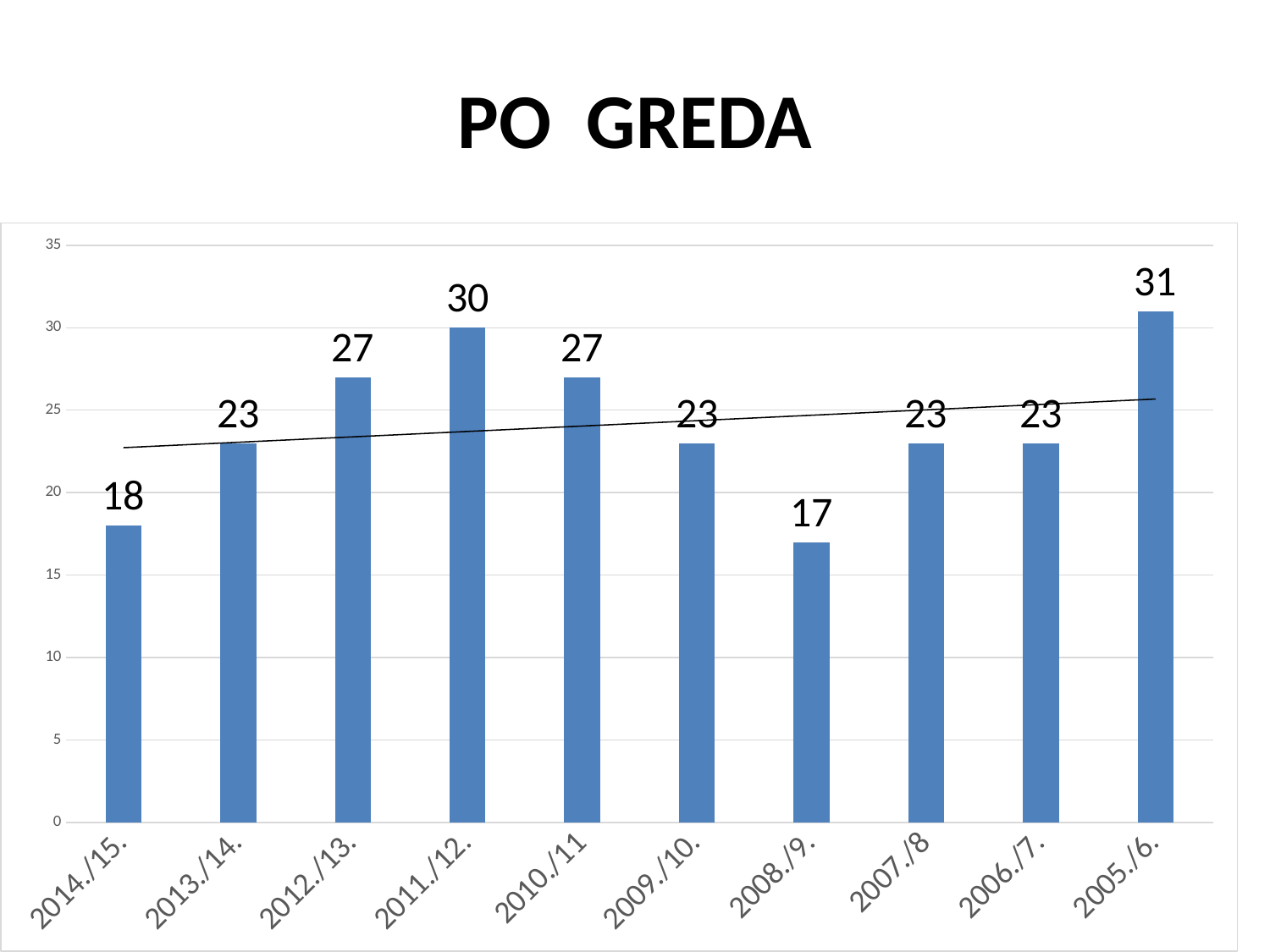
What is the title of the slide? PO GREDA What is the difference between the values for 2005./6. and 2014./15.? 13 What is the value for 2008./9.? 17 What is the value for 2014./15.? 18 Which is larger, the value for 2012./13. or the value for 2009./10.? 2012./13. Which category has the lowest value? 2008./9. What kind of chart is shown on the slide? bar chart How many categories are shown on the x axis? 10 What is the value for 2011./12.? 30 Is the value for 2010./11 greater or less than 25? greater Which category has the highest value? 2005./6. What is the difference between the values for 2011./12. and 2012./13.? 3